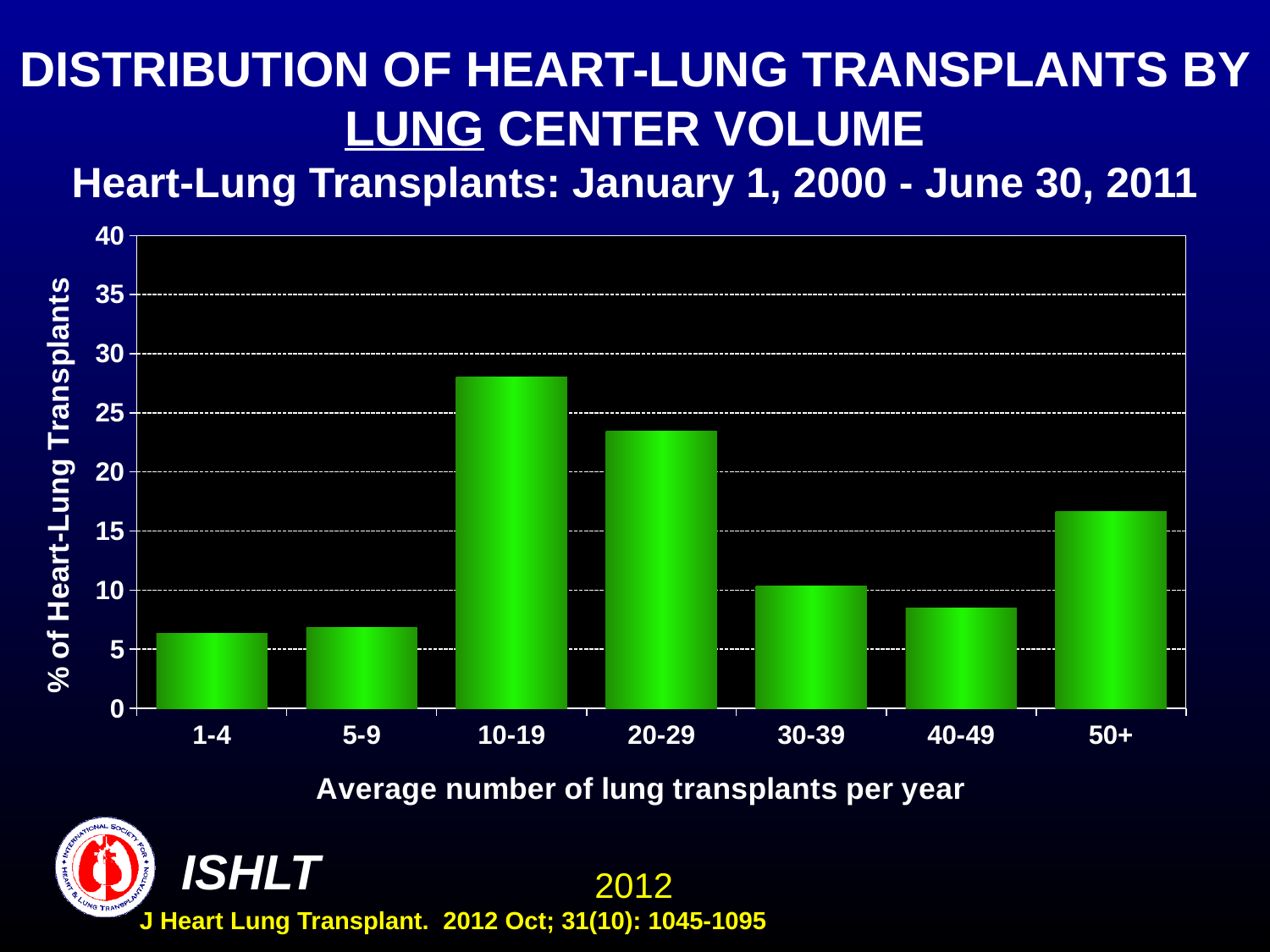
What kind of chart is shown on the slide? bar chart Is the value for the 20-29 category greater or less than 20? greater What is the label of the y axis? % of Heart-Lung Transplants Is the value for the 1-4 category greater or less than 10? less Is the value for the 50+ category greater or less than 15? greater Which has a larger percentage of heart-lung transplants, the 30-39 category or the 40-49 category? 30-39 What is the label of the x axis? Average number of lung transplants per year Which center volume category has the highest percentage of heart-lung transplants? 10-19 How many center volume categories are shown on the x axis? 7 Which has a larger percentage of heart-lung transplants, the 20-29 category or the 50+ category? 20-29